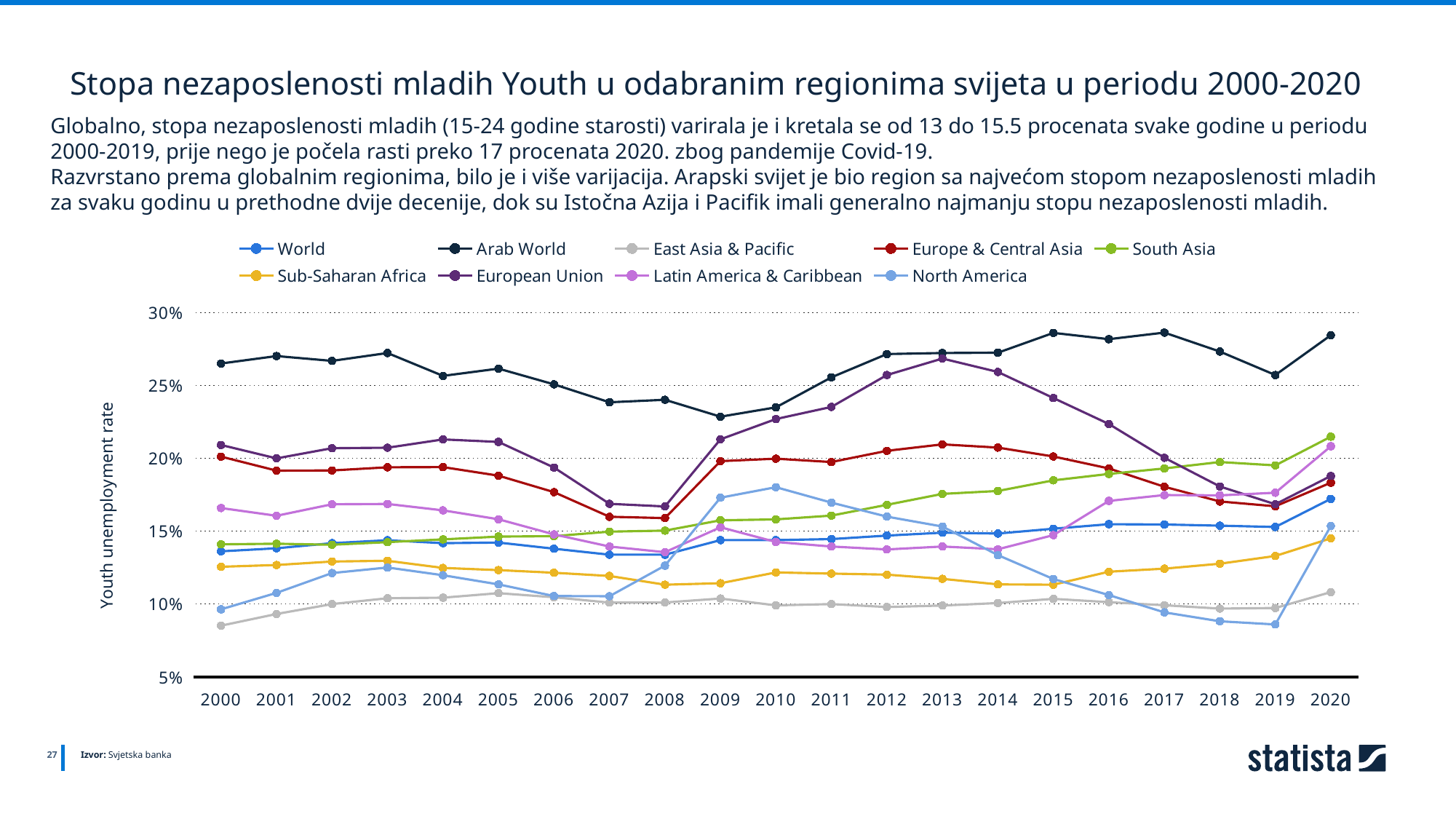
Which is higher in 2017, Arab World or European Union? Arab World Which region has the lowest youth unemployment rate in 2000? East Asia & Pacific Is the value for European Union in 2013 greater or less than 25%? greater Which region has the highest youth unemployment rate in 2020? Arab World What is the label of the y axis? Youth unemployment rate Does the North America line rise or fall from 2010 to 2019? fall How many years are shown along the x axis? 21 Which is higher in 2020, Sub-Saharan Africa or East Asia & Pacific? Sub-Saharan Africa How many series does the legend list? 9 Is the value for Arab World in 2020 greater or less than 25%? greater Is the value for East Asia & Pacific in 2000 greater or less than 10%? less What type of chart is shown on the slide? line chart